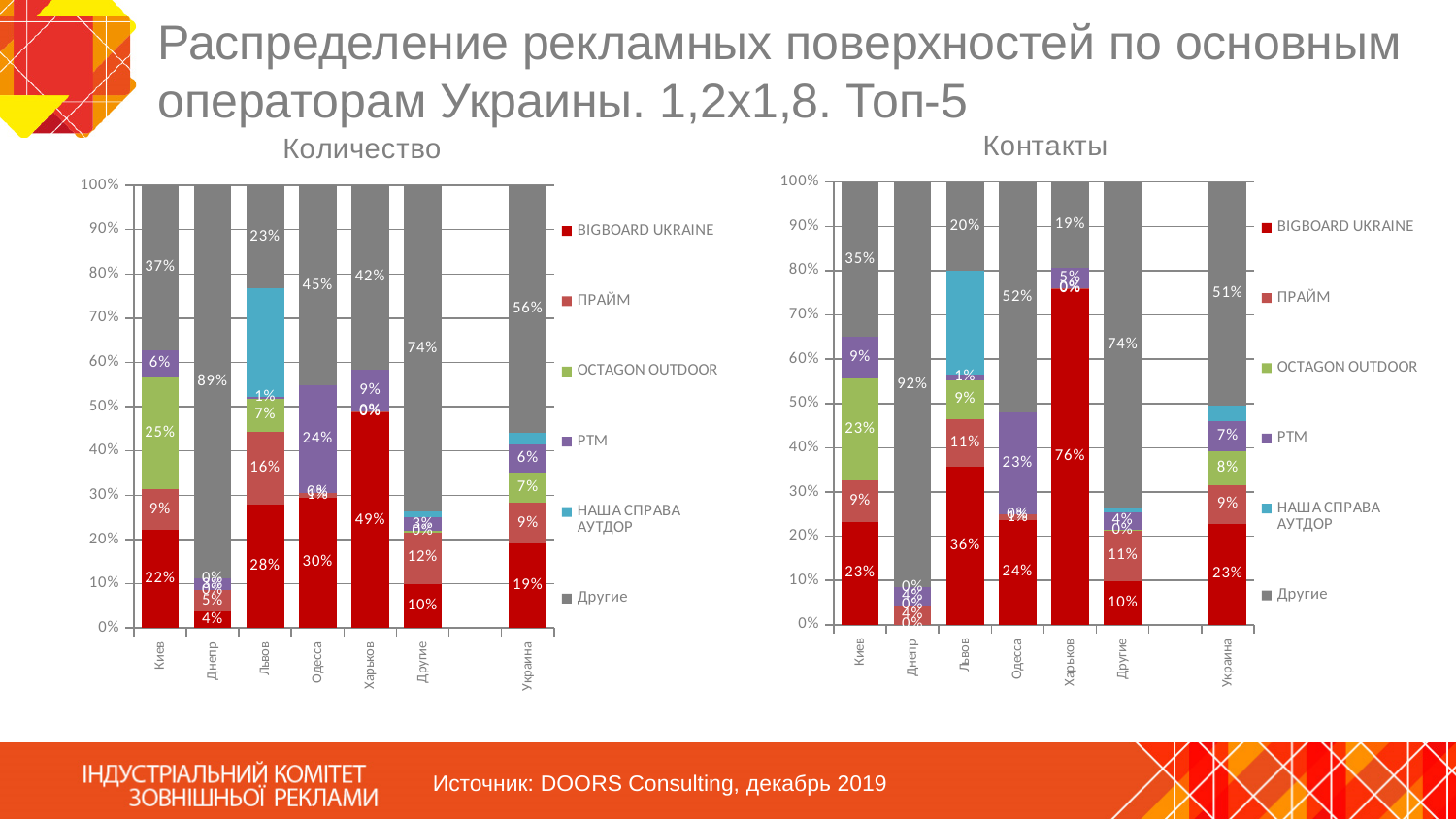
On the "Количество" chart, which category has the highest "Другие" share? Днепр What type of chart is the "Контакты" chart? Stacked bar chart On the "Контакты" chart, what is the BIGBOARD UKRAINE share for Харьков? 76% How many categories are shown on the x axis of the "Количество" chart? 7 On the "Количество" chart, what is the BIGBOARD UKRAINE share for Киев? 22% On the "Количество" chart, what is the "Другие" share for Днепр? 89% On the "Контакты" chart, which is larger: the BIGBOARD UKRAINE share for Львов or for Одесса? Львов On the "Контакты" chart, which city has the highest BIGBOARD UKRAINE share? Харьков On the "Контакты" chart, what is the "Другие" share for Украина? 51% On the "Количество" chart, what is the OCTAGON OUTDOOR share for Киев? 25% How many series does the legend of the "Контакты" chart list? 6 On the "Количество" chart, what is the difference between the BIGBOARD UKRAINE shares of Харьков and Одесса? 19%